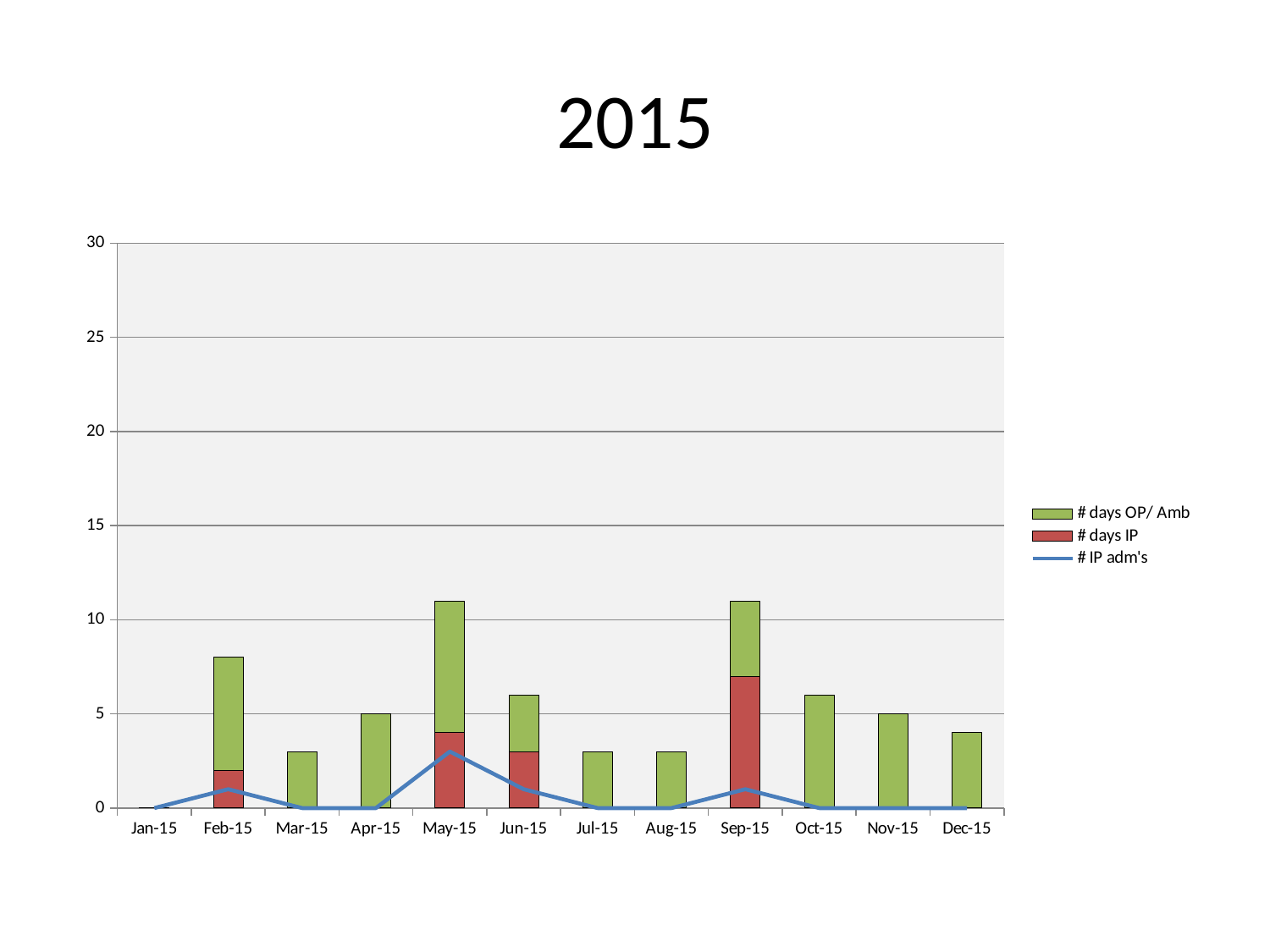
How many months are shown on the x axis? 12 How many series does the legend list? 3 Is the total bar height for May-15 greater or less than 10? greater What kind of chart is shown on the slide? A combined stacked bar and line chart What is the value of the # IP adm's line for Jan-15? 0 Which series is drawn as a line rather than bars? # IP adm's Is the total bar height for Feb-15 greater or less than 5? greater What is the title of the slide? 2015 Is the total bar height for Dec-15 greater or less than 5? less Which month has the taller total bar, Feb-15 or Mar-15? Feb-15 Which month has the lowest total bar height? Jan-15